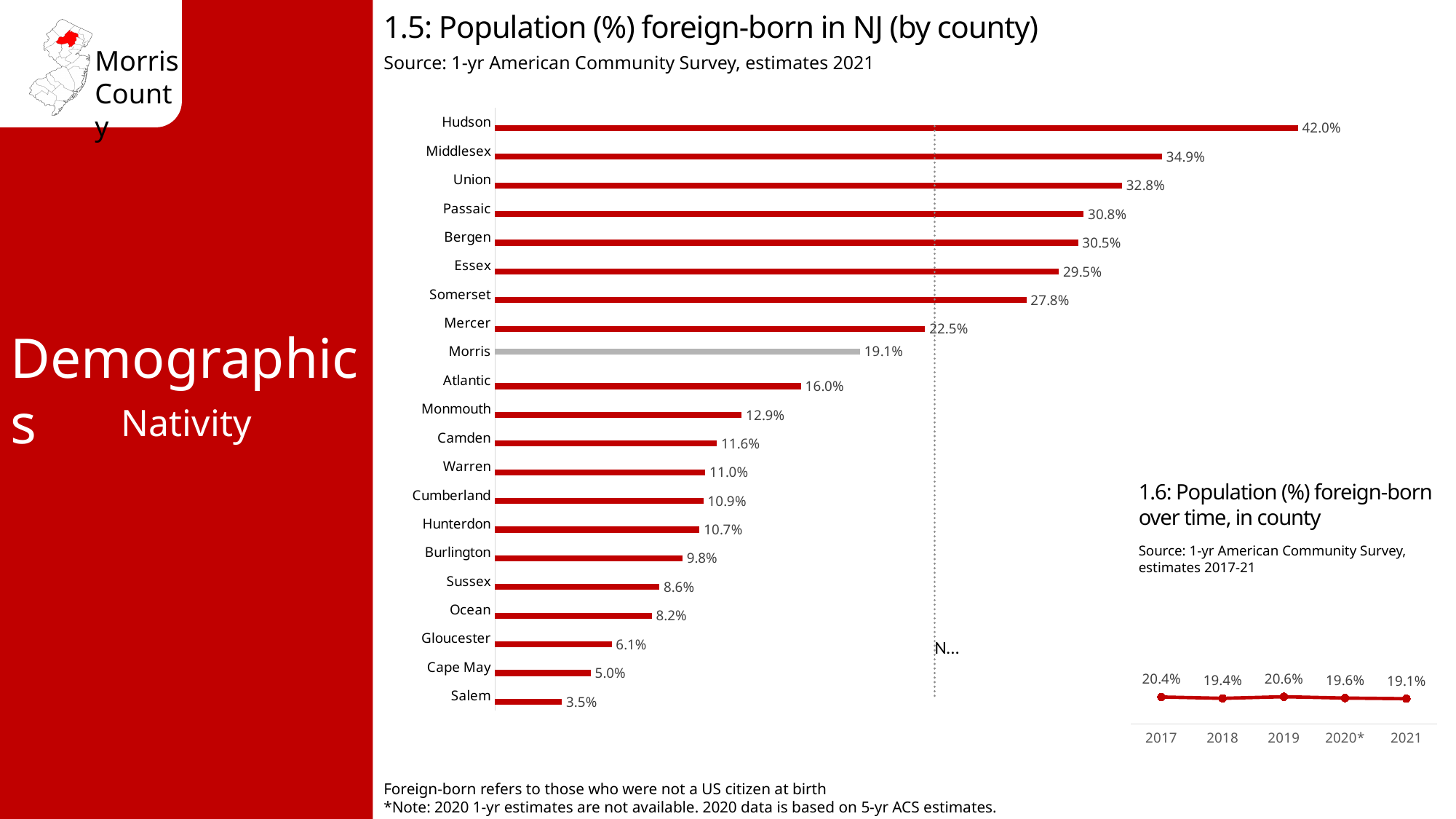
In chart 1.5 (Population (%) foreign-born in NJ by county), which is larger, Passaic or Bergen? Passaic In chart 1.5 (Population (%) foreign-born in NJ by county), how many counties are shown? 21 In chart 1.6 (Population (%) foreign-born over time, in county), which year has the lowest value? 2021 What kind of chart is chart 1.5 (Population (%) foreign-born in NJ by county)? bar chart In chart 1.5 (Population (%) foreign-born in NJ by county), which county has the highest value? Hudson In chart 1.5 (Population (%) foreign-born in NJ by county), what is the value for Morris? 19.1% In chart 1.5 (Population (%) foreign-born in NJ by county), what is the value for Hudson? 42.0% In chart 1.5 (Population (%) foreign-born in NJ by county), which county has the lowest value? Salem In chart 1.5 (Population (%) foreign-born in NJ by county), what is the difference between Hudson and Middlesex? 7.1% What kind of chart is chart 1.6 (Population (%) foreign-born over time, in county)? line chart In chart 1.6 (Population (%) foreign-born over time, in county), what is the difference between 2017 and 2021? 1.3% In chart 1.6 (Population (%) foreign-born over time, in county), what is the value for 2019? 20.6%